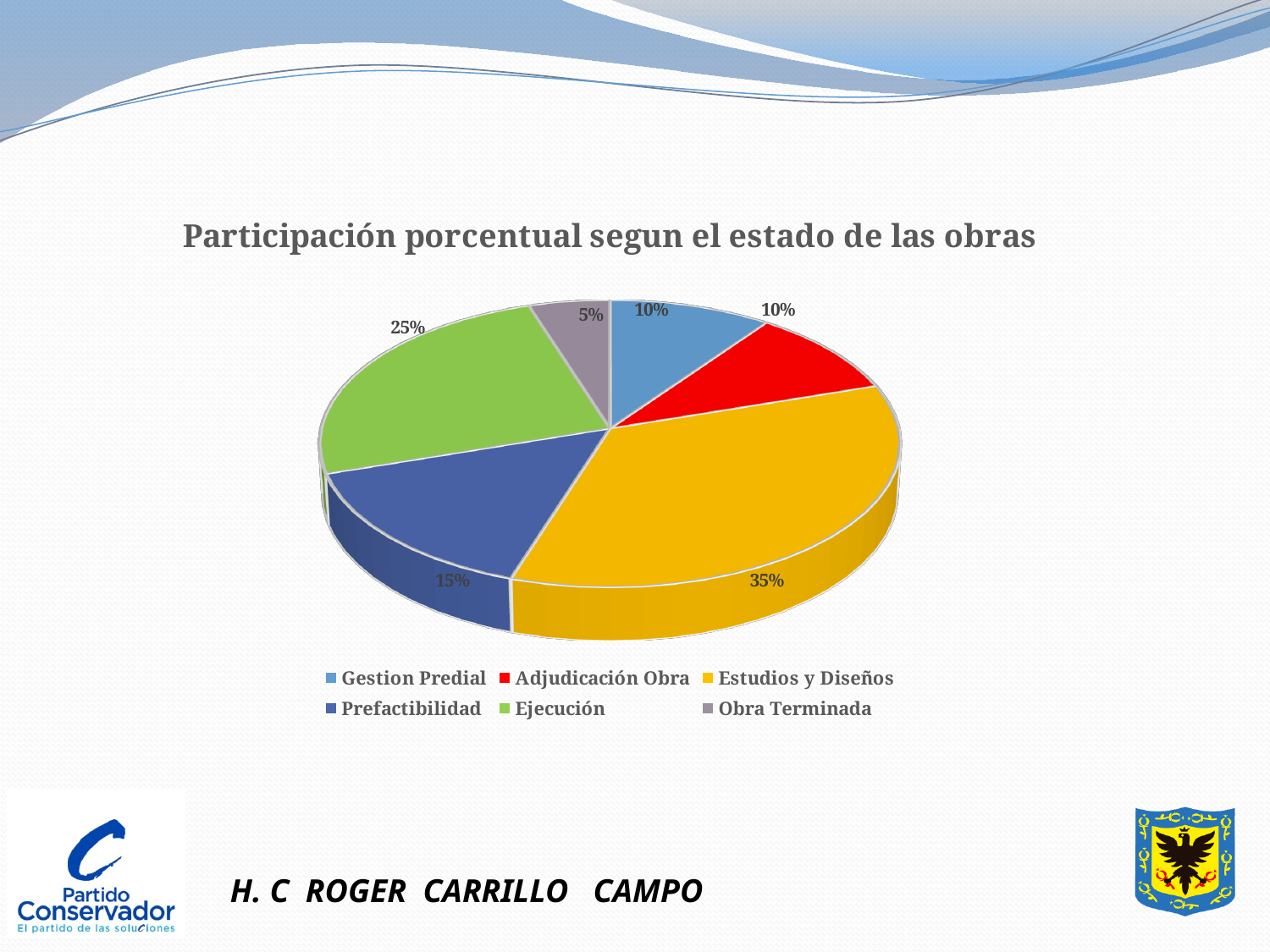
What is the difference in percentage points between Estudios y Diseños and Ejecución? 10 How many categories are shown in the pie chart? 6 What percentage of the pie does Obra Terminada represent? 5% What percentage of the pie does Estudios y Diseños represent? 35% Which category has the largest share of the pie? Estudios y Diseños What percentage of the pie does Ejecución represent? 25% What percentage of the pie does Prefactibilidad represent? 15% Which category has the smallest share of the pie? Obra Terminada What colour is the Estudios y Diseños slice? Yellow What is the title of the chart? Participación porcentual segun el estado de las obras What type of chart is shown on the slide? Pie chart Which has a larger share, Prefactibilidad or Ejecución? Ejecución